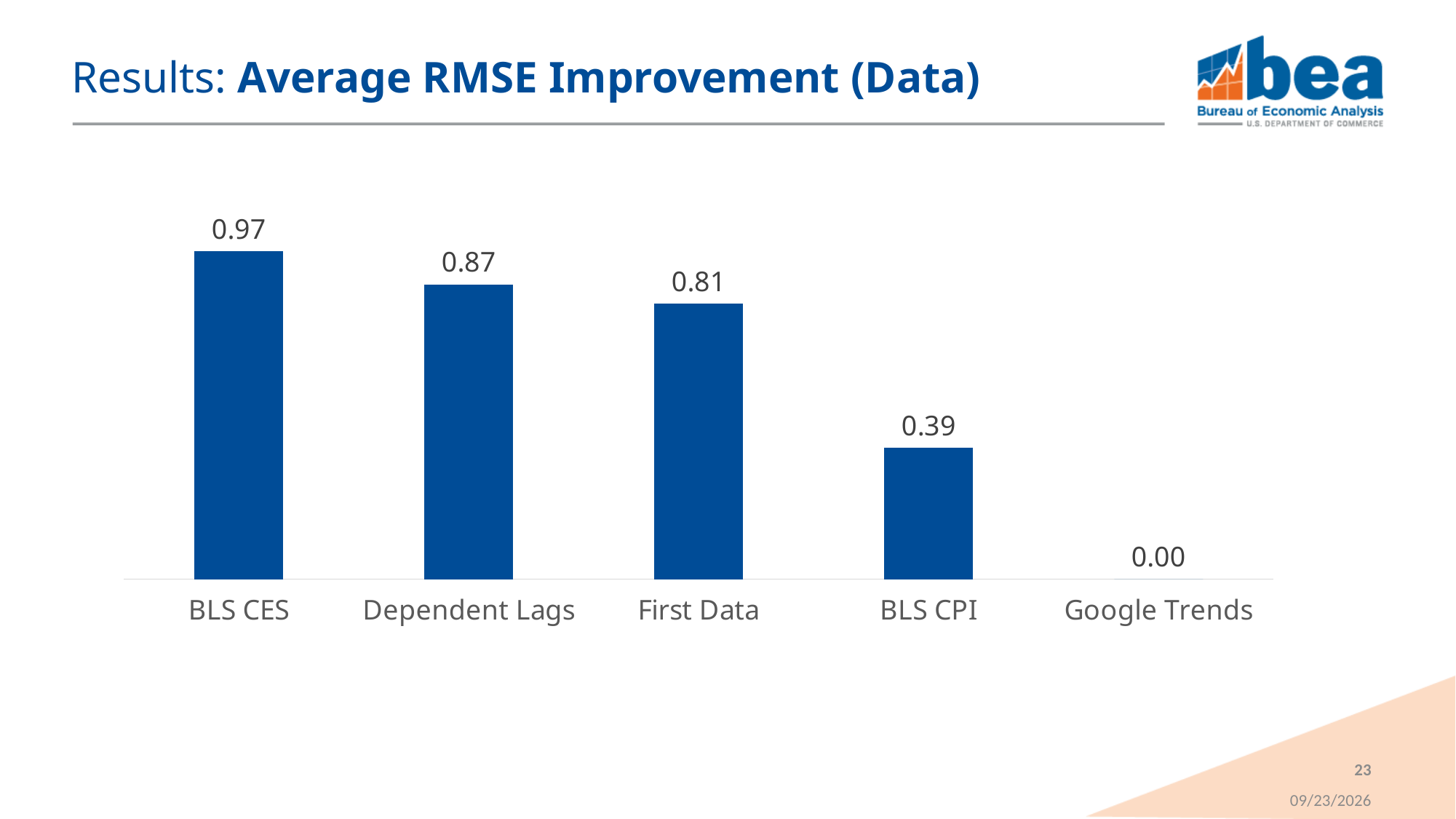
How many categories are shown in the chart? 5 What is the value for BLS CPI? 0.39 What is the value for Google Trends? 0.00 Do the values rise or fall from left to right across the categories? Fall Which is larger, the value for Dependent Lags or the value for First Data? Dependent Lags What is the value for First Data? 0.81 What is the value for Dependent Lags? 0.87 Which category has the lowest value? Google Trends What kind of chart is shown on the slide? Bar chart What is the difference between the values for BLS CES and BLS CPI? 0.58 What is the value for BLS CES? 0.97 Which category has the highest value? BLS CES